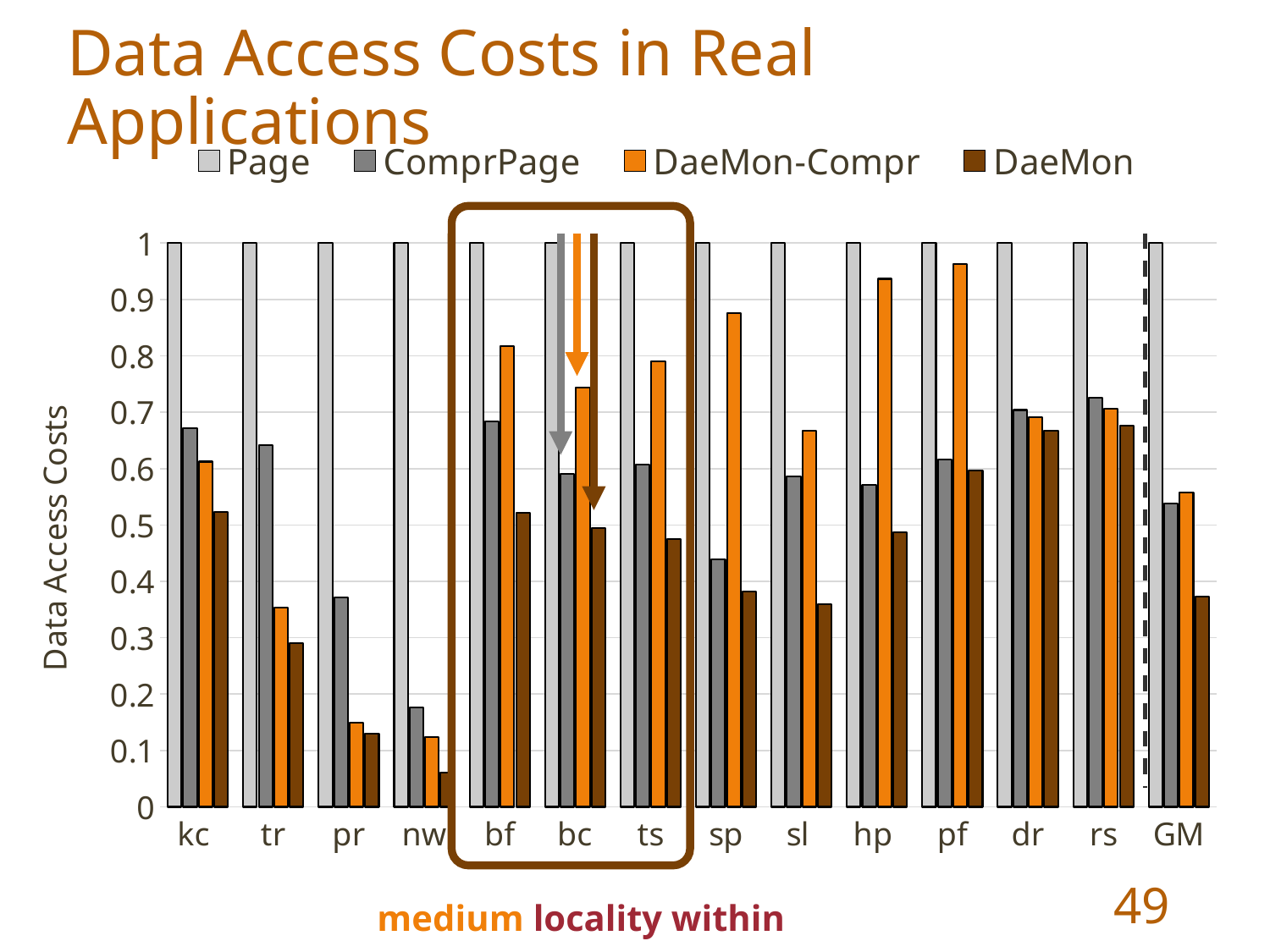
Is the DaeMon value for nw greater or less than 0.1? less Is the DaeMon value for GM greater or less than 0.4? less Which is larger, the DaeMon value for kc or the DaeMon value for tr? kc How many categories are shown along the x axis? 14 Is the DaeMon-Compr value for pf greater or less than 0.9? greater What is the title of the y axis? Data Access Costs How many series does the legend list? 4 What is the value of the Page series for GM? 1 Which category has the lowest DaeMon value? nw What is the value of the Page series for kc? 1 What kind of chart is shown on the slide? bar chart